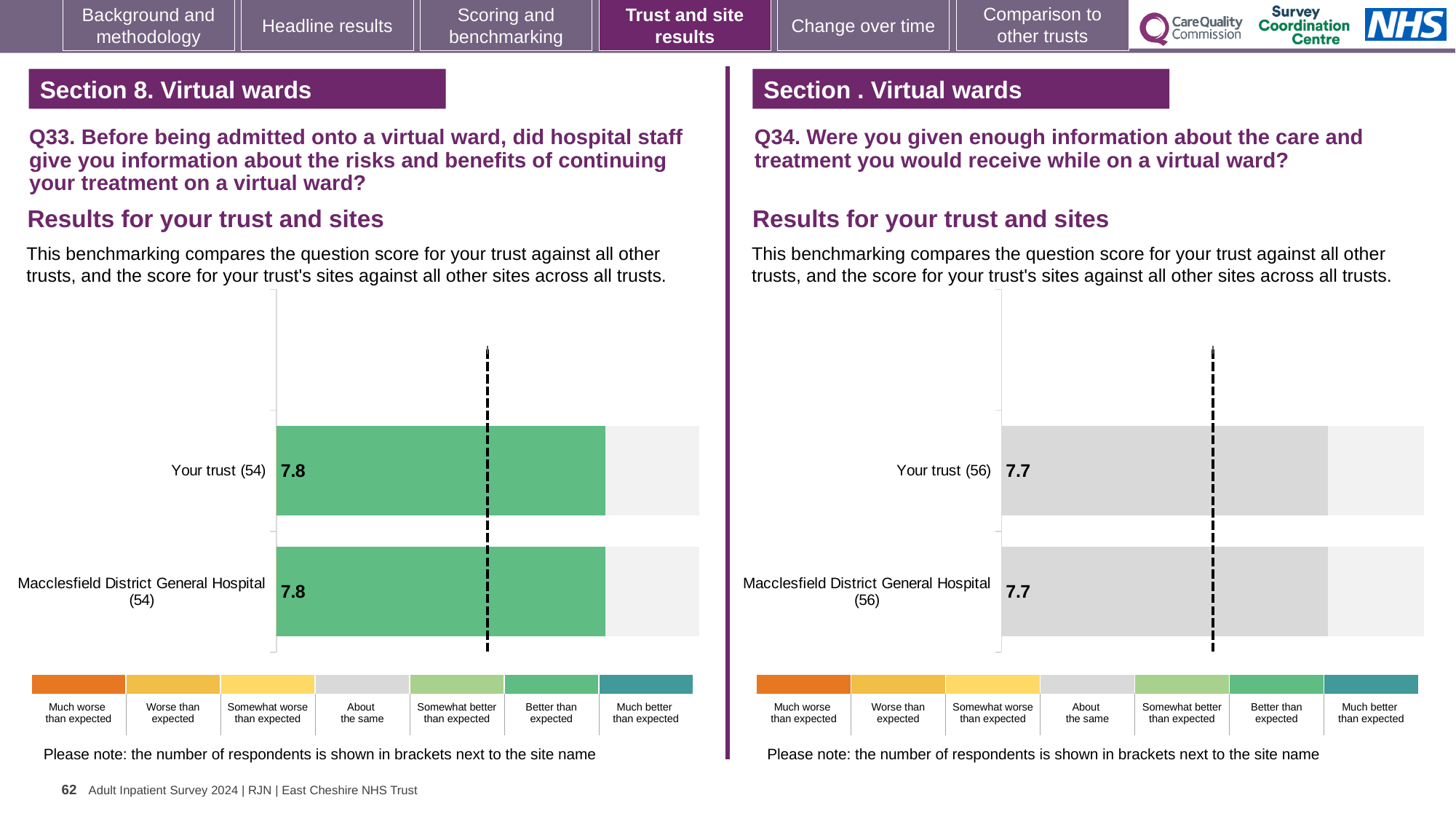
In the Q33 chart on the left, which benchmark category does the colour of the bars correspond to according to the key? Better than expected In the Q34 chart on the right, how many respondents are shown in brackets for Macclesfield District General Hospital? 56 How many bars are plotted in the Q33 chart on the left? 2 In the Q33 chart on the left, what is the score for Your trust? 7.8 Is the Your trust score in the Q33 chart on the left greater or less than the Your trust score in the Q34 chart on the right? greater In the Q33 chart on the left, how many respondents are shown in brackets for Your trust? 54 What is the difference between the Your trust score in the Q33 chart and the Your trust score in the Q34 chart? 0.1 In the Q34 chart on the right, which benchmark category does the colour of the bars correspond to according to the key? About the same What type of chart is used in the Q34 chart on the right? Bar chart In the Q33 chart on the left, what is the score for Macclesfield District General Hospital? 7.8 In the Q34 chart on the right, what is the score for Macclesfield District General Hospital? 7.7 In the Q34 chart on the right, what is the score for Your trust? 7.7